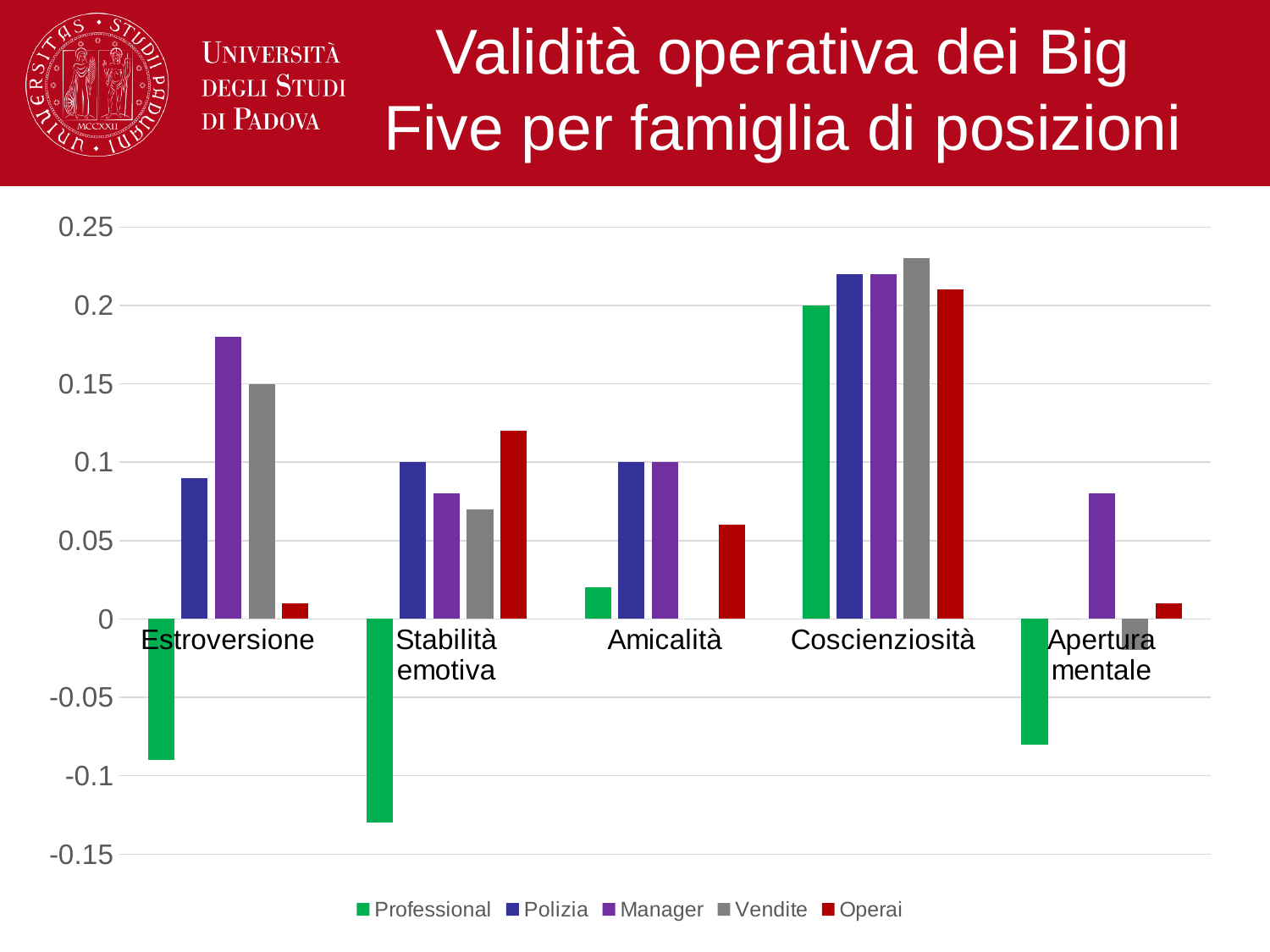
Is the Operai value for Stabilità emotiva greater or less than 0.1? greater Is the Manager value for Estroversione greater or less than 0.15? greater What is the Polizia value for Stabilità emotiva? 0.1 Is the Professional value for Stabilità emotiva greater or less than -0.1? less Which colour represents the Operai series in the legend? red How many series does the legend list? 5 For Coscienziosità, which is larger: the Vendite value or the Professional value? Vendite How many categories are shown on the x axis? 5 What kind of chart is shown on the slide? bar chart In which category is the Professional value lowest? Stabilità emotiva In which category is the Professional value highest? Coscienziosità For Estroversione, which is larger: the Manager value or the Polizia value? Manager